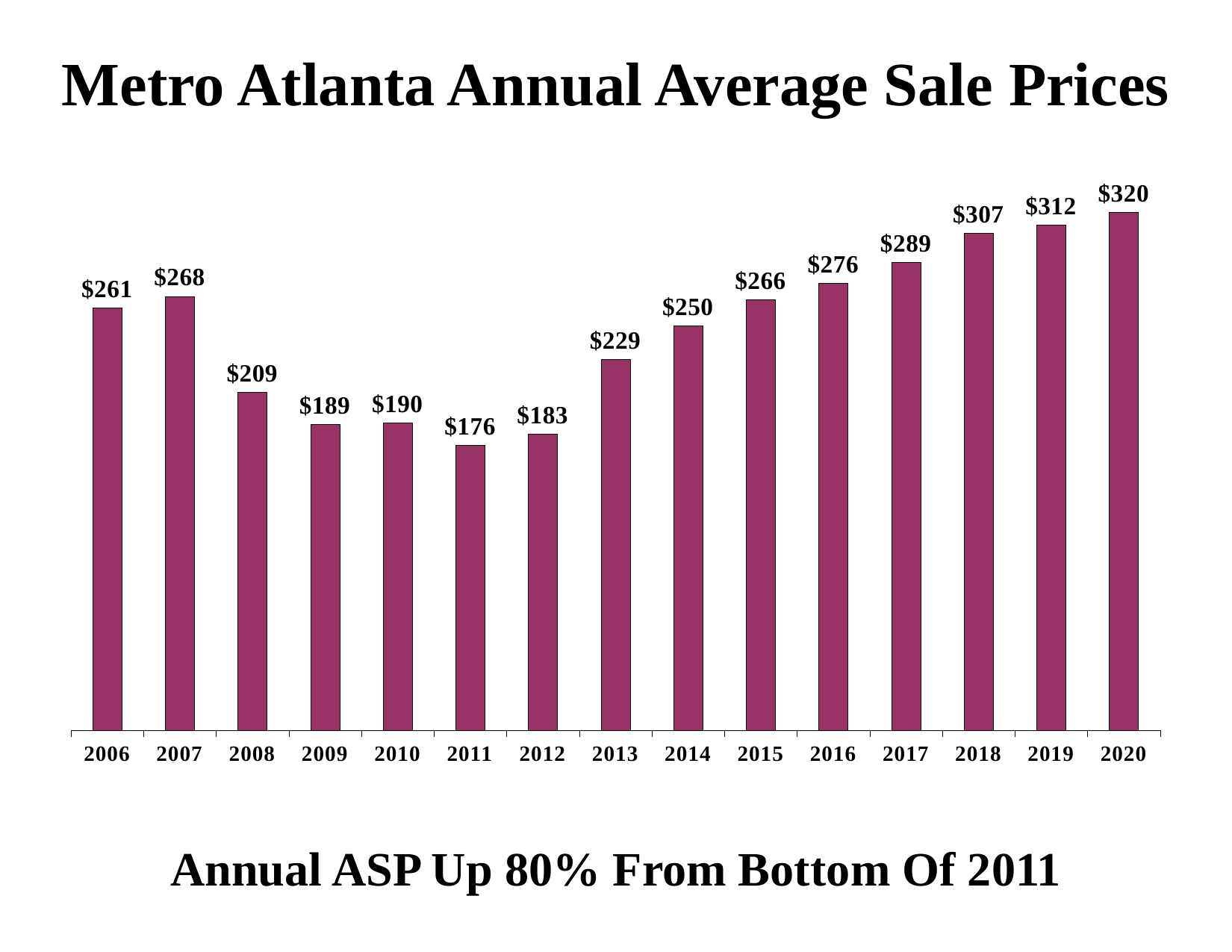
What is the difference between the 2020 value and the 2011 value? $144 What is the average sale price shown for 2011? $176 Do the values rise or fall from 2011 to 2020? Rise What kind of chart is shown on the slide? Bar chart How many years are shown on the x axis? 15 What is the title of the chart? Metro Atlanta Annual Average Sale Prices Which year has the highest average sale price? 2020 What is the average sale price shown for 2017? $289 What is the difference between the 2007 value and the 2008 value? $59 Which year has a higher average sale price, 2009 or 2012? 2009 Which year has a higher average sale price, 2006 or 2015? 2015 Which year has the lowest average sale price? 2011